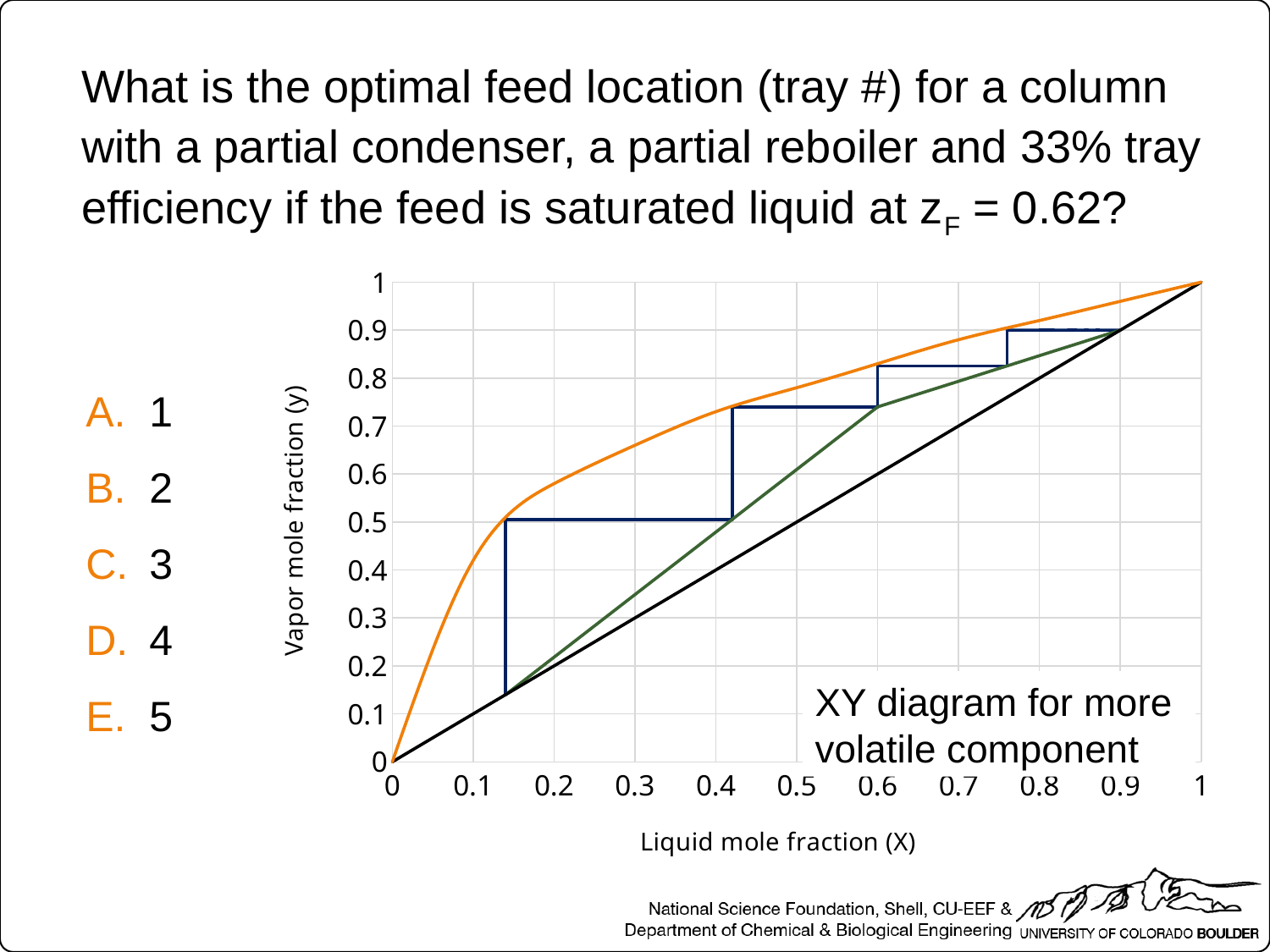
Does the orange equilibrium curve rise or fall as the liquid mole fraction increases from 0 to 1? rise What is the vapor mole fraction of the black diagonal line at a liquid mole fraction of 1? 1 What is the label of the x axis? Liquid mole fraction (X) Is the vapor mole fraction on the orange curve at a liquid mole fraction of 0.1 greater or less than 0.6? less What text annotation is printed inside the plot area? XY diagram for more volatile component How many horizontal stair steps does the dark blue stepped line have? 4 Is the vapor mole fraction on the orange curve at a liquid mole fraction of 0.5 greater or less than 0.7? greater What kind of chart is shown on the slide? line chart What is the maximum value shown on the y axis? 1 At a liquid mole fraction of 0.5, which is higher: the orange curve or the black diagonal line? the orange curve What is the vapor mole fraction of the black diagonal line at a liquid mole fraction of 0? 0 Is the vapor mole fraction on the orange curve at a liquid mole fraction of 0.2 greater or less than 0.5? greater